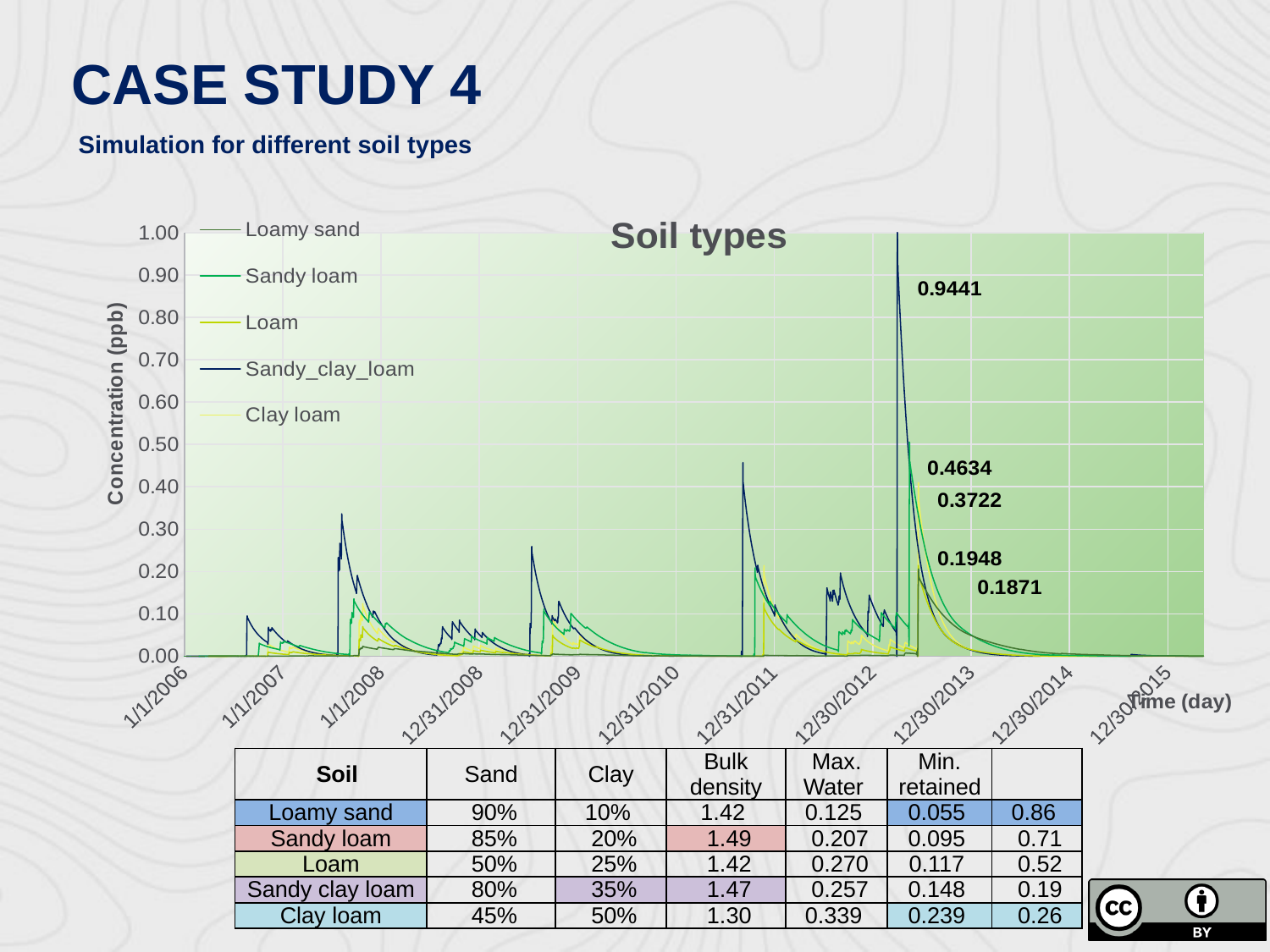
What is the title of the chart on the slide? Soil types Which series reaches the highest peak on the "Soil types" chart? Sandy_clay_loam How many data labels are printed on the "Soil types" chart? 5 What type of chart is shown under the title "Soil types"? line chart How many series does the legend of the "Soil types" chart list? 5 Is the highest peak reached by any series before 12/31/2008 greater or less than 0.50? less What is the highest data label value shown on the "Soil types" chart? 0.9441 What is the y-axis title of the "Soil types" chart? Concentration (ppb) What is the difference between the two largest data labels, 0.9441 and 0.4634, on the "Soil types" chart? 0.4807 Which is larger on the "Soil types" chart: the data label 0.3722 or the data label 0.1948? 0.3722 What is the lowest data label value shown on the "Soil types" chart? 0.1871 Is the highest peak of the Sandy_clay_loam series greater or less than 0.90? greater